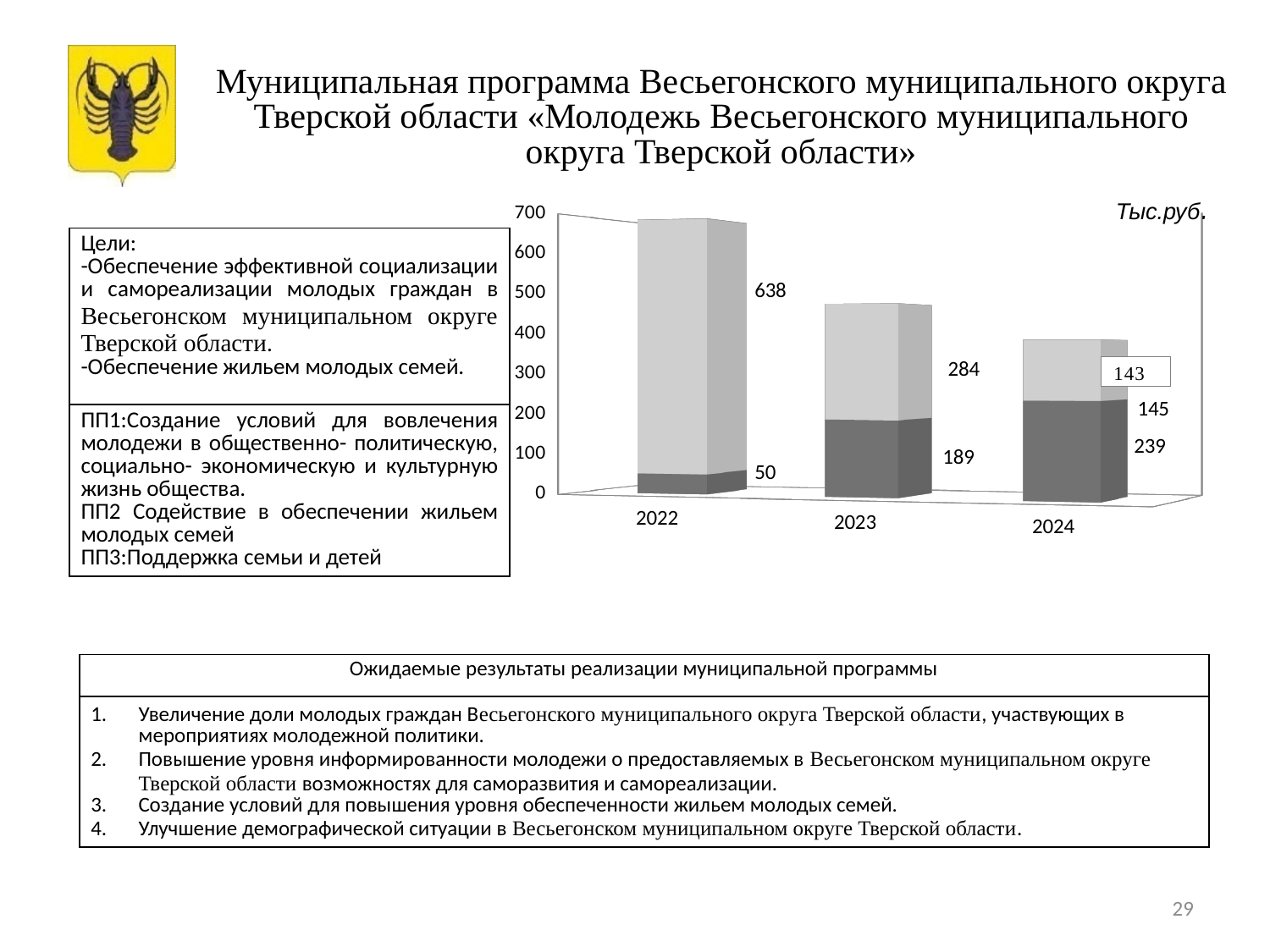
Which year has the tallest stacked bar? 2022 What is the value of the dark bottom segment of the 2023 bar? 189 What kind of chart is shown on the slide? bar chart What unit label is shown in the top right corner of the chart? Тыс.руб. What is the difference between the light upper segment in 2022 and the light upper segment in 2023? 354 What is the value of the light upper segment of the 2023 bar? 284 What is the value of the dark bottom segment of the 2024 bar? 239 What is the value of the dark bottom segment of the 2022 bar? 50 What is the value of the light upper segment of the 2022 bar? 638 What is the total of the 2023 stacked bar? 473 How many years are shown on the x axis of the chart? 3